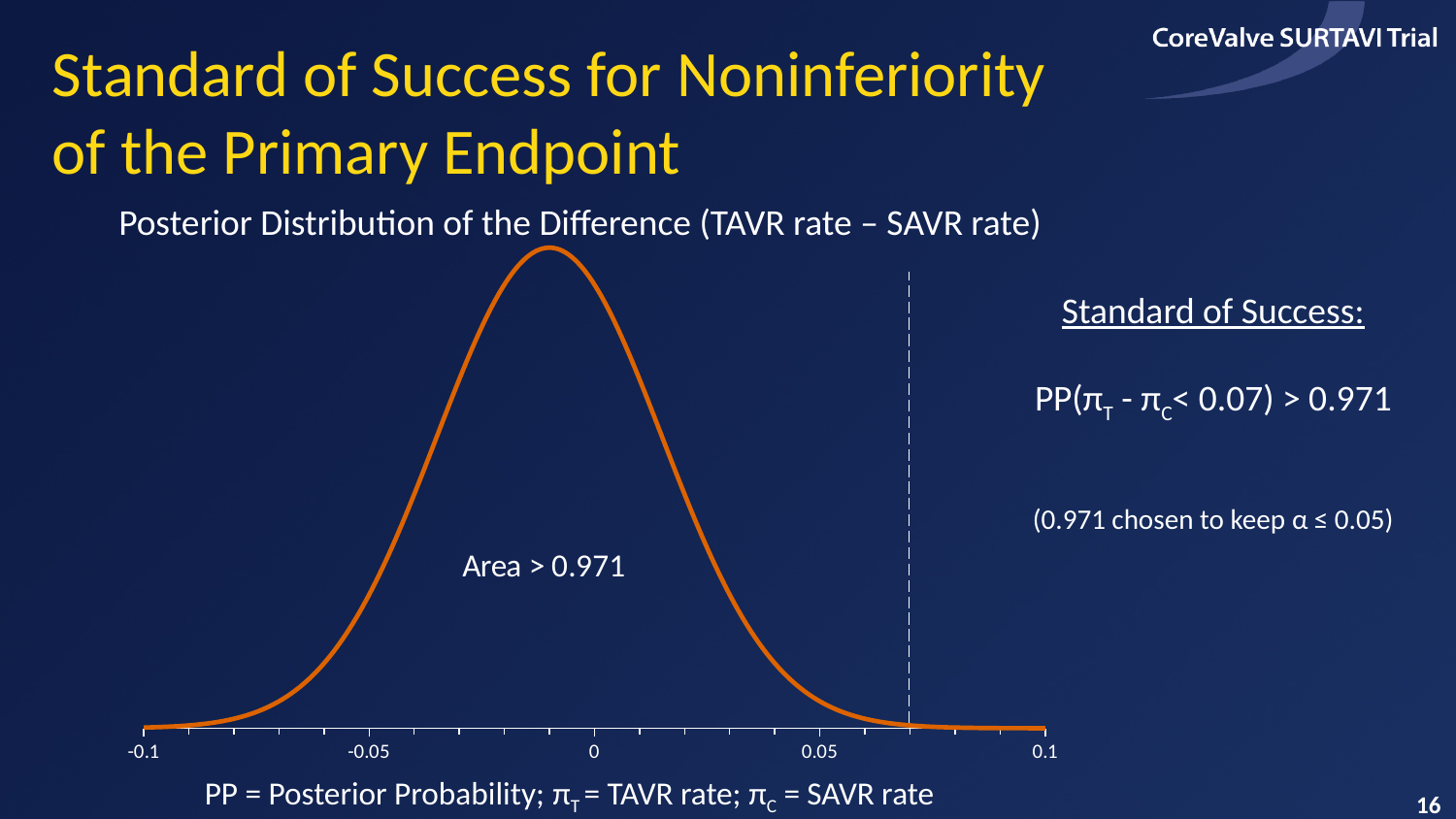
At what x value is the dashed vertical line drawn, according to the standard of success on the slide? 0.07 What text is printed inside the curve? Area > 0.971 What is the title of the chart? Posterior Distribution of the Difference (TAVR rate – SAVR rate) Is the peak of the curve at an x value greater or less than -0.05? greater How many tick labels are printed on the x axis? 5 What colour is the plotted curve? orange How many curves are plotted on the chart? 1 What is the highest value labelled on the x axis? 0.1 Is the peak of the curve at an x value greater or less than 0? less How does the curve behave moving from left to right along the x axis? rises to a peak then falls What is the lowest value labelled on the x axis? -0.1 What kind of chart is shown on the slide? line chart